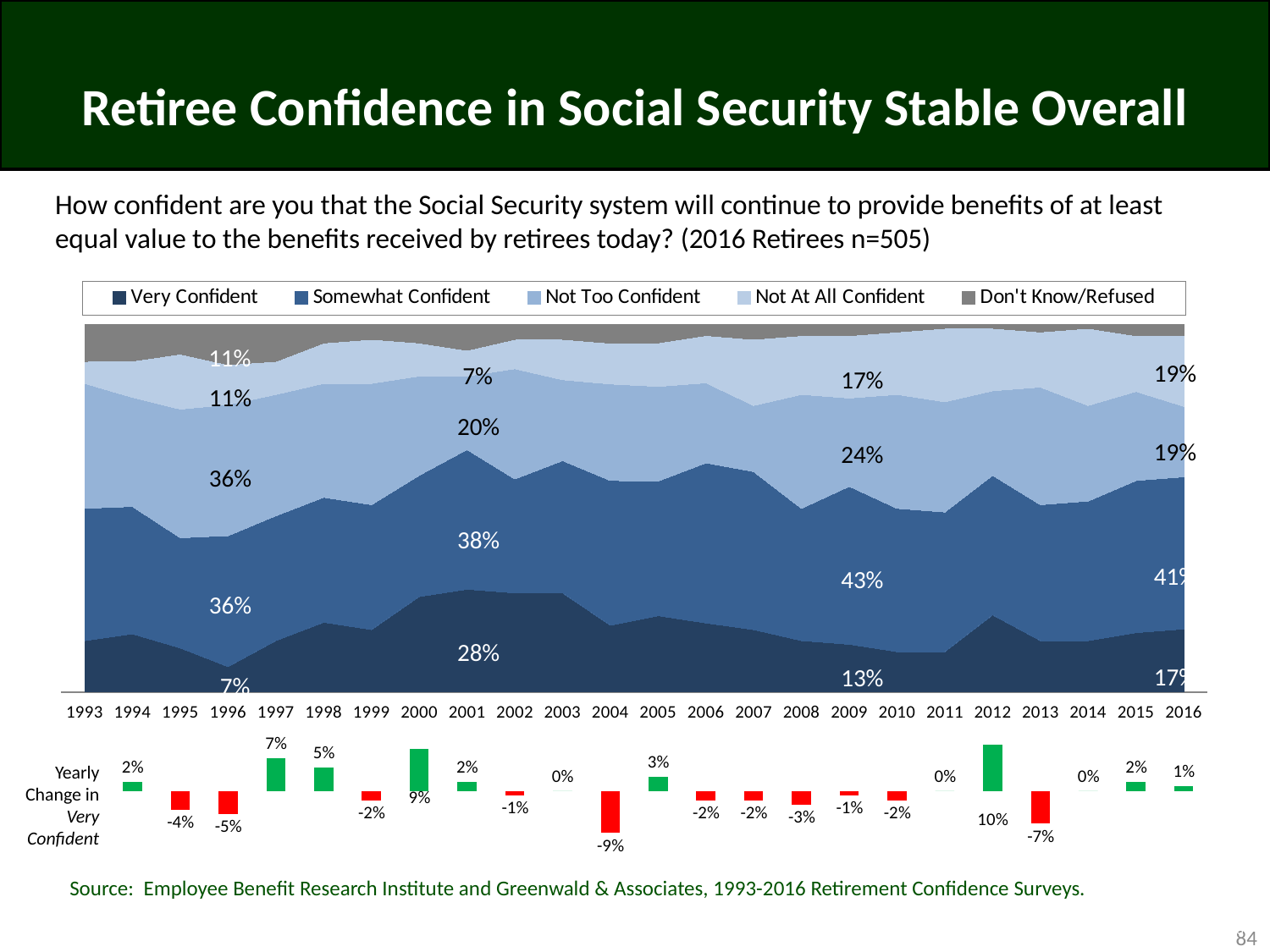
In the stacked area chart, what percentage of retirees were Not Too Confident in 2001? 20% In the stacked area chart, what percentage of retirees were Very Confident in 1996? 7% In the Yearly Change in Very Confident bar chart, which year has the largest increase? 2012 In the stacked area chart, how many years are shown on the x axis? 24 In the stacked area chart, what percentage of retirees were Very Confident in 2016? 17% In the Yearly Change in Very Confident bar chart, which year has the largest decrease? 2004 In the Yearly Change in Very Confident bar chart, what is the value for 2000? 9% How many series does the legend of the stacked area chart list? 5 In the Yearly Change in Very Confident bar chart, what is the value for 2013? -7% What kind of chart shows the Yearly Change in Very Confident at the bottom of the slide? Bar chart In the stacked area chart, what percentage of retirees were Somewhat Confident in 2009? 43% In the stacked area chart, by how many percentage points did the Very Confident share differ between 2001 and 2009? 15